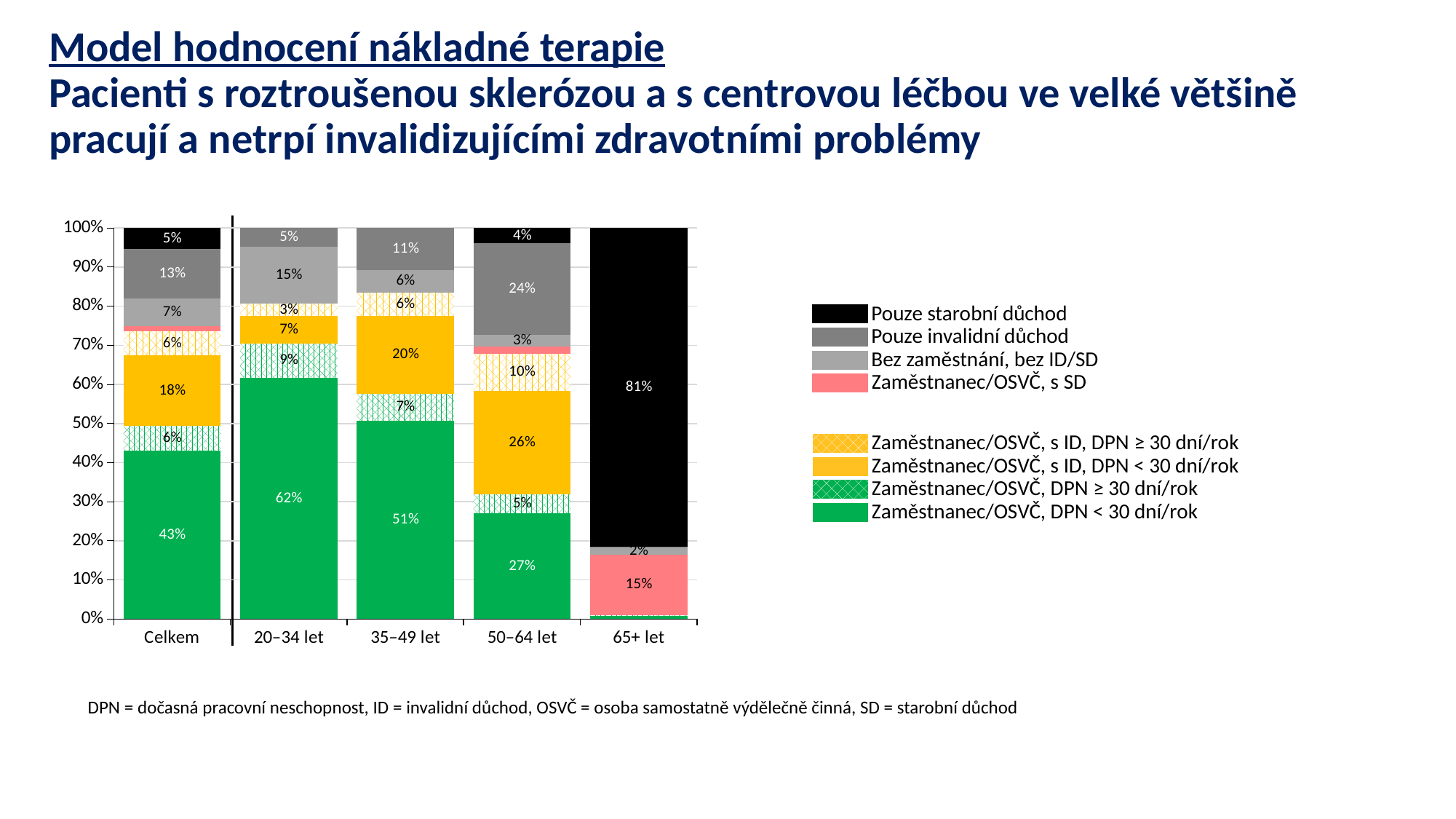
What kind of chart is shown on the slide? Stacked bar chart Which has a larger share of Bez zaměstnání, bez ID/SD: 20–34 let or 35–49 let? 20–34 let What colour represents Pouze starobní důchod in the legend? Black Which age group has the highest share of Zaměstnanec/OSVČ, DPN < 30 dní/rok? 20–34 let What is the value for Pouze invalidní důchod in the 50–64 let group? 24% What is the value for Zaměstnanec/OSVČ, DPN < 30 dní/rok in the 20–34 let group? 62% Which category has the highest share of Pouze invalidní důchod? 50–64 let What is the difference in percentage points between the Zaměstnanec/OSVČ, s ID, DPN < 30 dní/rok share for 50–64 let and for 20–34 let? 19 percentage points How many series does the legend list? 8 What is the value for Zaměstnanec/OSVČ, s SD in the 65+ let group? 15% What share of the 65+ let group is Pouze starobní důchod? 81% How many categories are shown on the x axis? 5